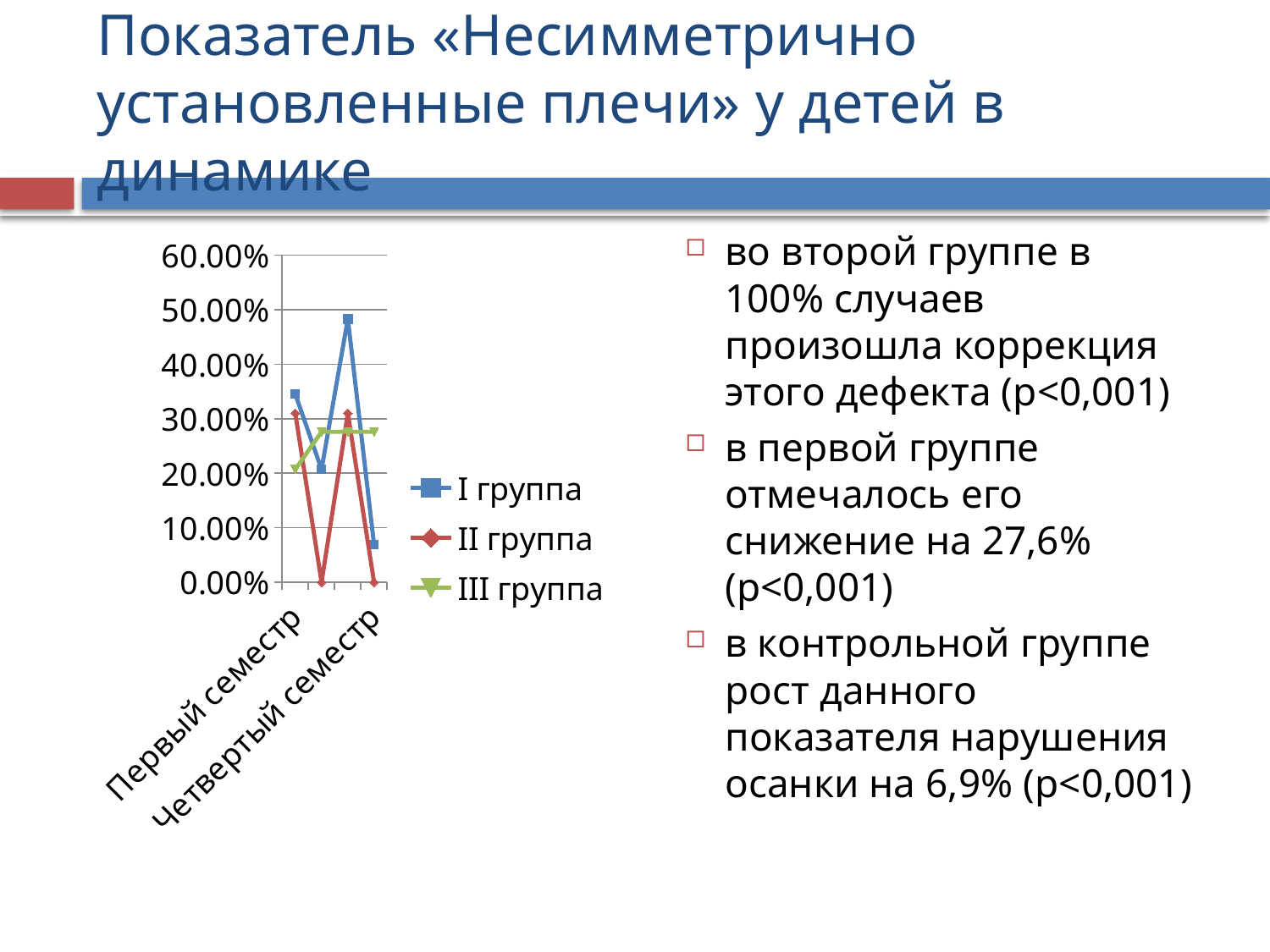
Is the value for II группа in Первый семестр greater or less than 20%? greater What is the value for II группа in Четвертый семестр? 0.00% Which series are listed in the chart legend? I группа, II группа, III группа What kind of chart is shown on the slide? line chart Does the value for I группа rise or fall from Первый семестр to Четвертый семестр? fall Is the value for I группа in Четвертый семестр greater or less than 10%? less How many series does the chart legend list? 3 Is the value for III группа in Четвертый семестр greater or less than 30%? less In Четвертый семестр, which is larger: I группа or III группа? III группа Which series has the lowest value in Четвертый семестр? II группа In Первый семестр, which is larger: I группа or III группа? I группа